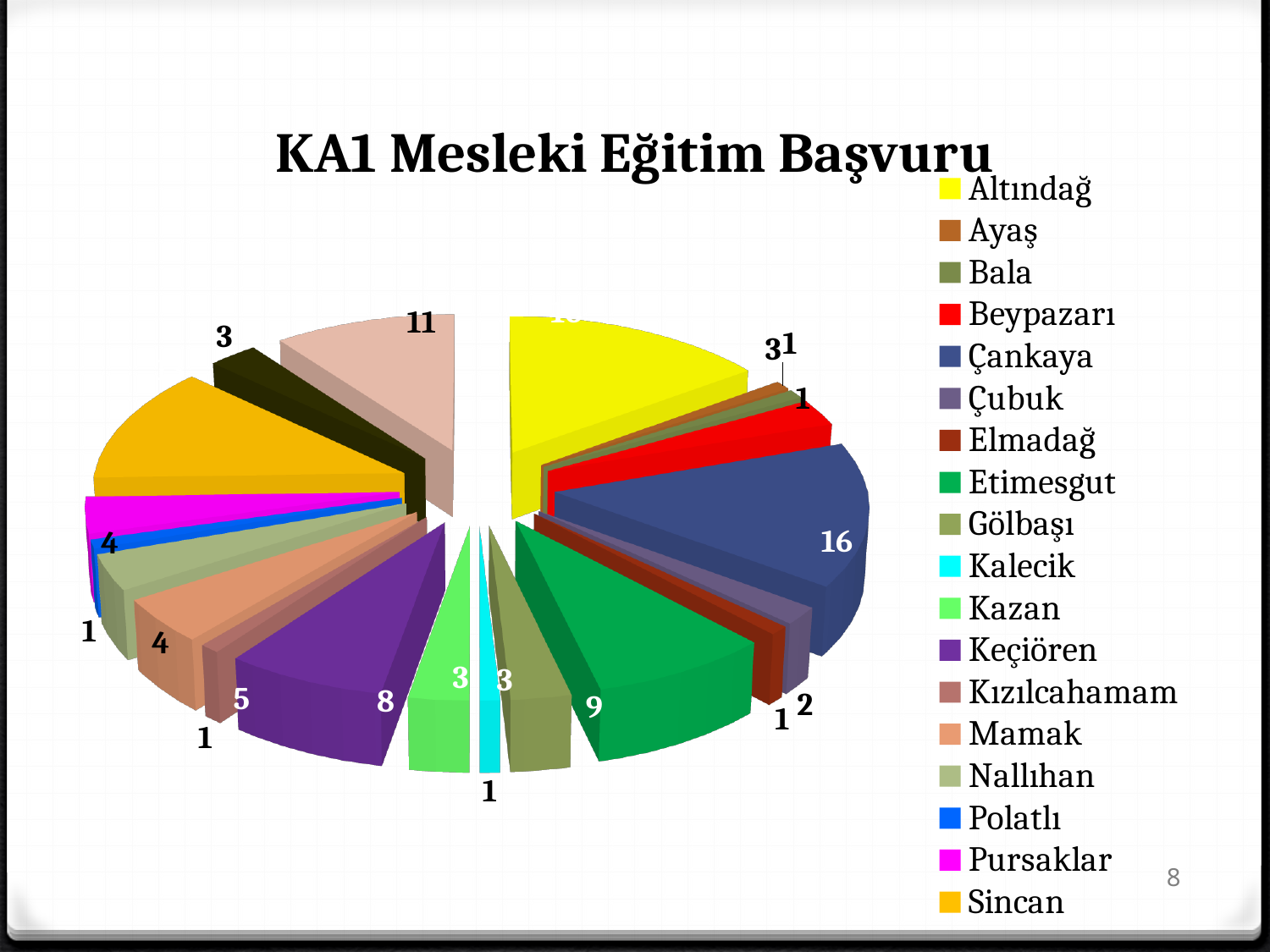
What is the value for Kazan? 3 Which colour represents Çankaya in the legend? dark blue What is the value for Çubuk? 2 What is the difference between the values for Keçiören and Kazan? 5 What is the difference between the values for Çankaya and Etimesgut? 7 Which is larger, the value for Etimesgut or the value for Keçiören? Etimesgut What is the value for Çankaya? 16 What kind of chart is shown on the slide? pie chart What is the title of the chart? KA1 Mesleki Eğitim Başvuru What is the value for Keçiören? 8 What is the value for Etimesgut? 9